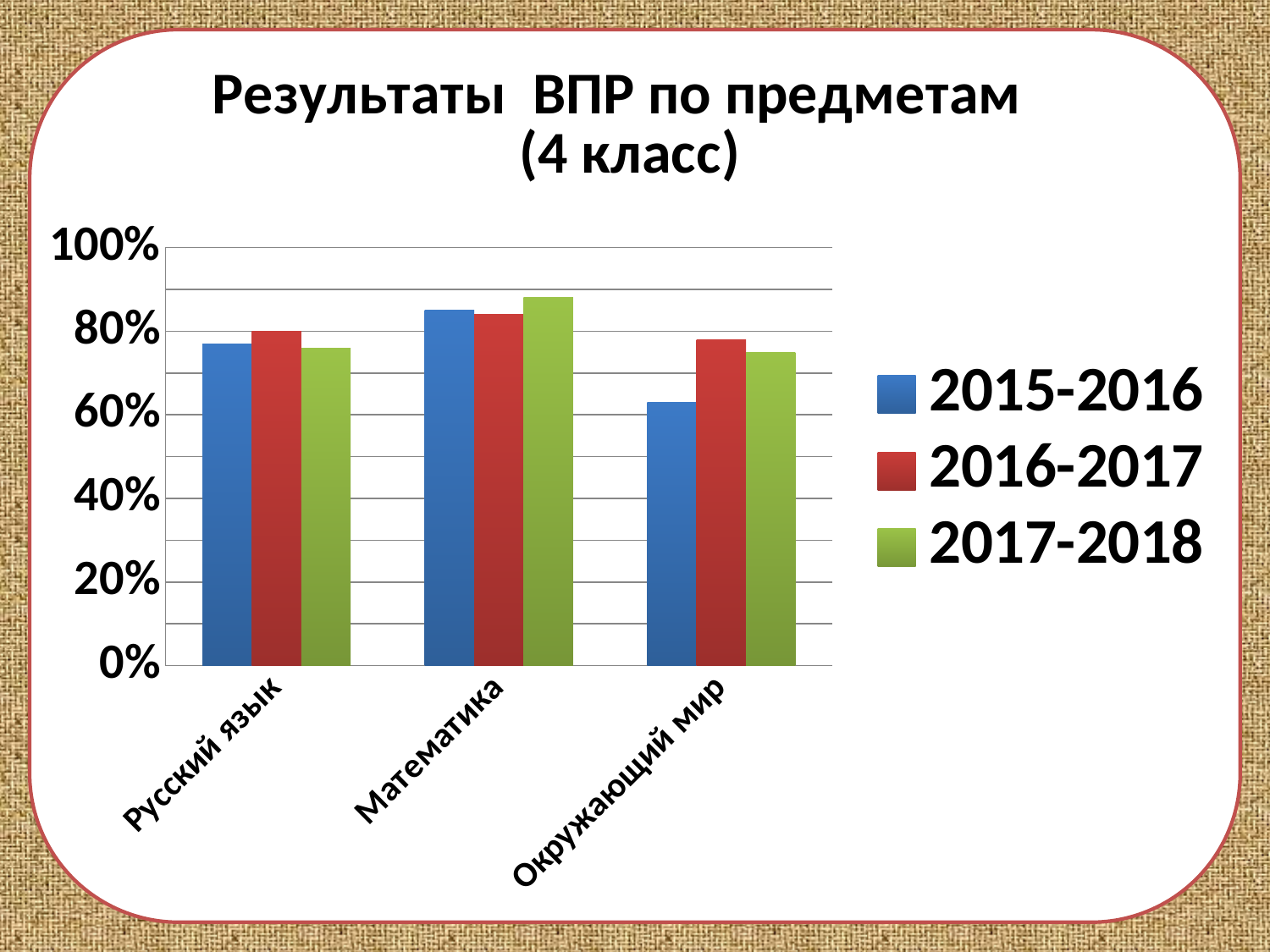
How many subjects (categories) are shown on the x axis? 3 Which series is shown in green in the legend? 2017-2018 Which subject has the highest value for 2017-2018? Математика Is the value for Окружающий мир in 2015-2016 greater or less than 80%? less For 2015-2016, which is larger: Математика or Окружающий мир? Математика How many series does the legend list? 3 Is the value for Математика in 2017-2018 greater or less than 80%? greater What is the title of the chart? Результаты ВПР по предметам (4 класс) For Окружающий мир, which is larger: 2015-2016 or 2016-2017? 2016-2017 Which subject has the lowest value for 2015-2016? Окружающий мир Is the value for Русский язык in 2015-2016 greater or less than 80%? less What kind of chart is shown on the slide? bar chart